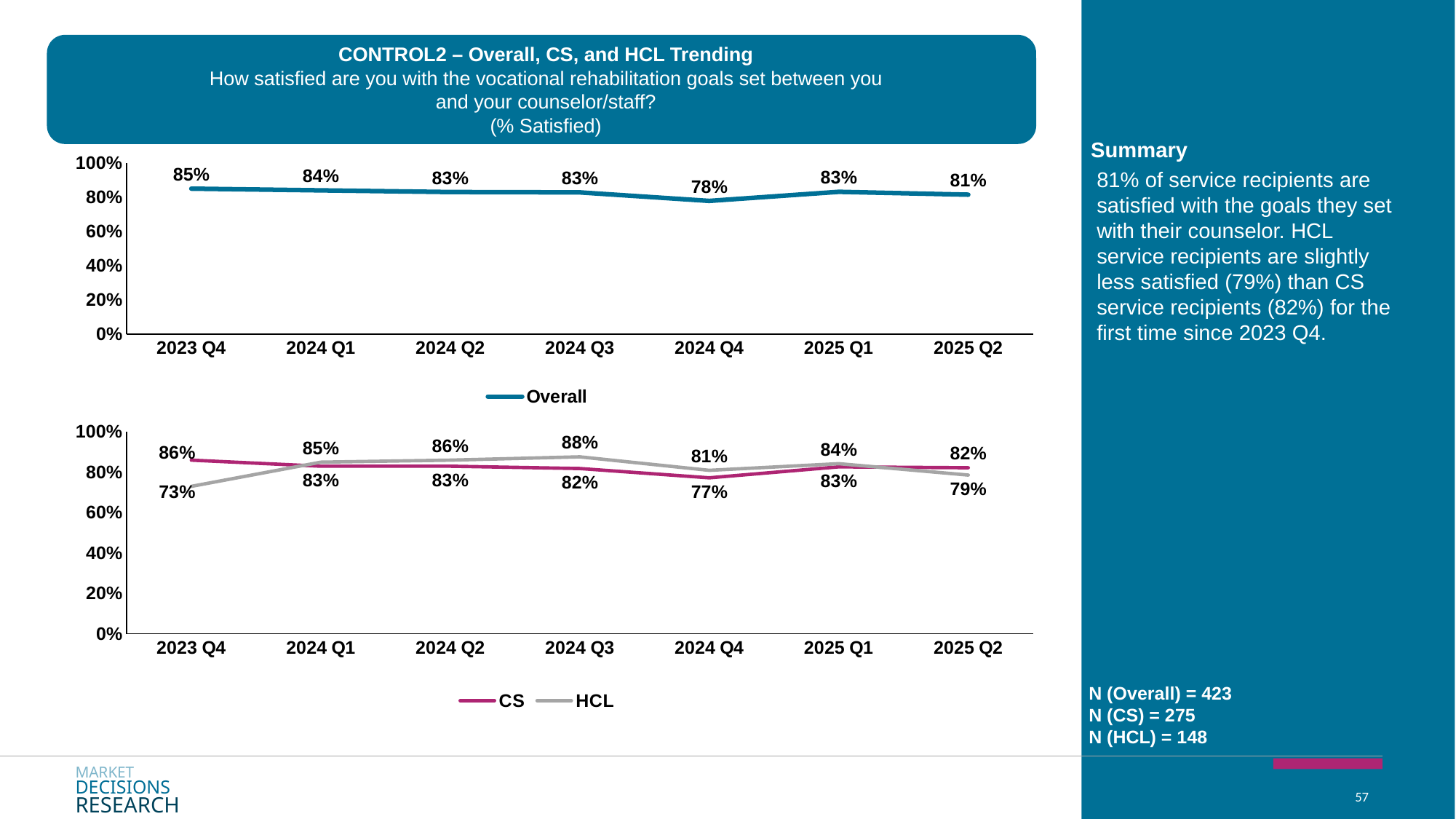
In the top chart (Overall), which quarter has the lowest value? 2024 Q4 In the bottom chart, what is the HCL value for 2023 Q4? 73% In the top chart (Overall), which quarter has the highest value? 2023 Q4 In the bottom chart, which is larger at 2025 Q2, CS or HCL? CS In the top chart (Overall), what is the difference between the 2023 Q4 value and the 2024 Q4 value? 7 percentage points In the bottom chart, which quarter has the highest HCL value? 2024 Q3 In the top chart (Overall), what is the value for 2025 Q2? 81% In the bottom chart, what is the CS value for 2024 Q4? 77% How many quarters are plotted on the x axis of the top chart? 7 How many series does the legend of the bottom chart list? 2 In the top chart (Overall), what is the value for 2024 Q4? 78% In the bottom chart, what is the difference between the HCL and CS values at 2024 Q3? 6 percentage points